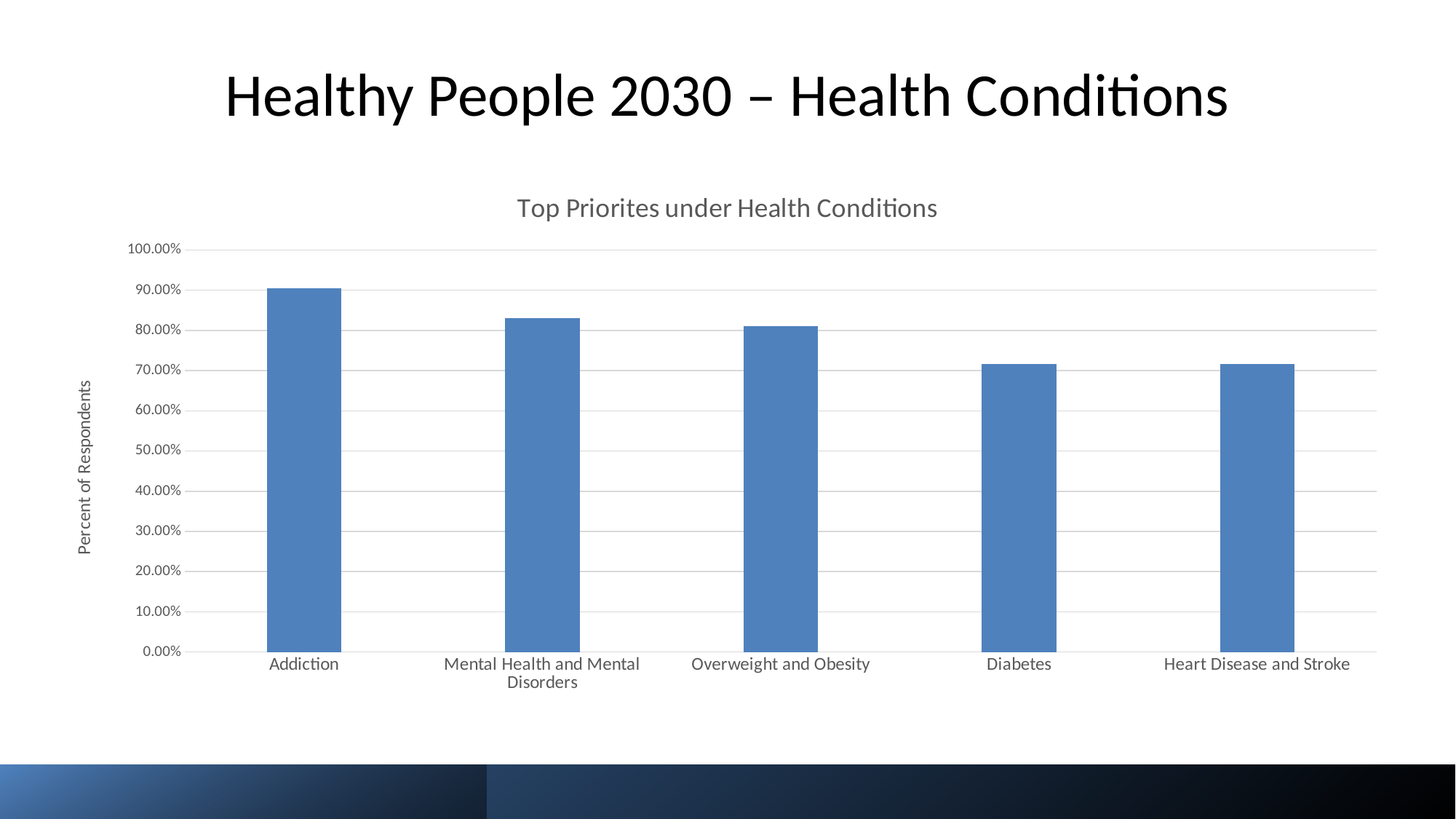
What is the label of the vertical axis? Percent of Respondents What type of chart is shown on the slide? bar chart How many health conditions are plotted in the chart? 5 Which has a larger percent of respondents, Addiction or Diabetes? Addiction Do the values generally rise or fall moving from left to right across the categories? fall Is the value for Mental Health and Mental Disorders greater or less than 80.00%? greater Is the value for Diabetes greater or less than 80.00%? less Which health condition has the highest percent of respondents? Addiction Is the value for Overweight and Obesity greater or less than 90.00%? less What is the title of the chart? Top Priorites under Health Conditions